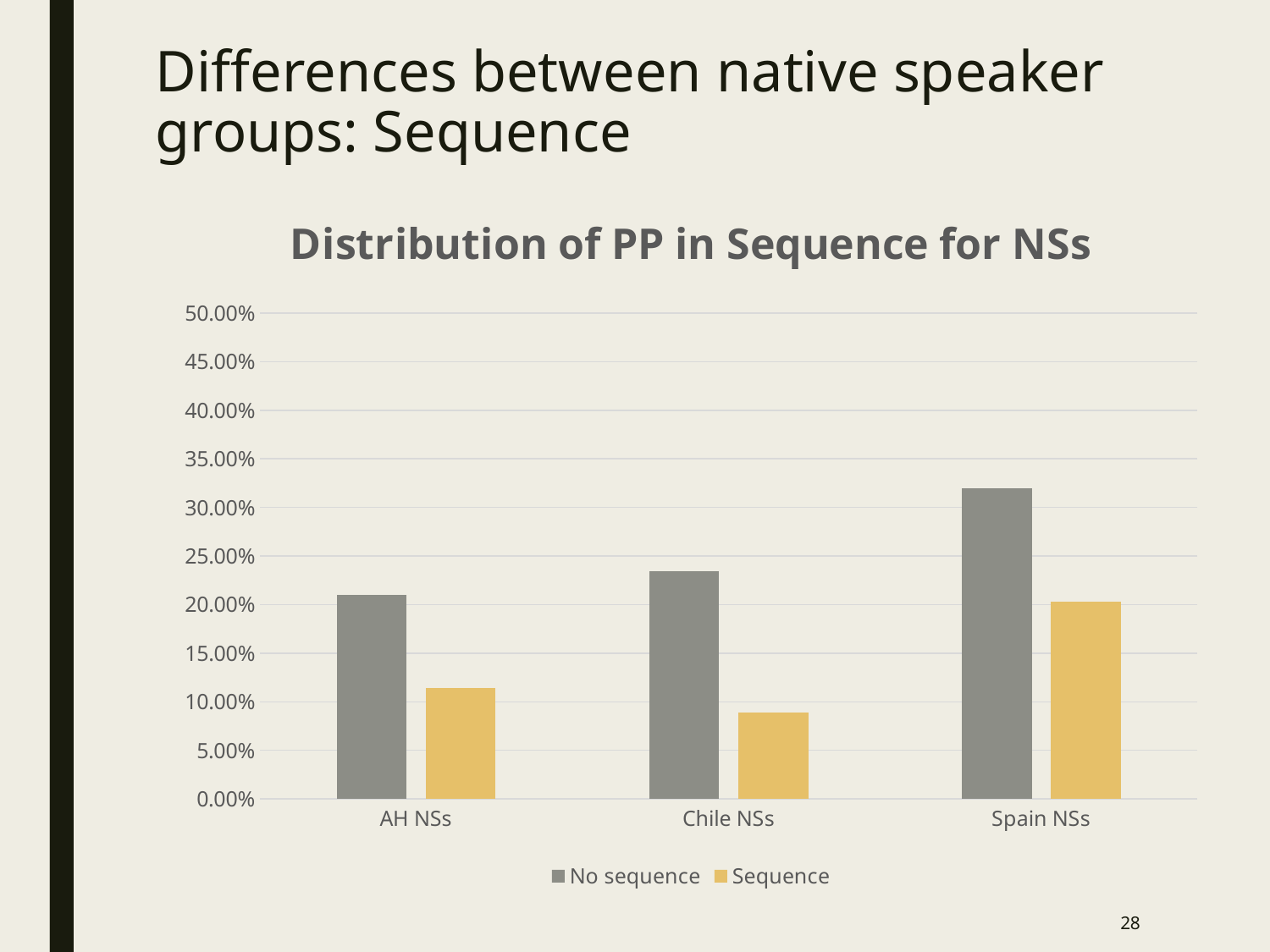
Is the Sequence value for Chile NSs greater or less than 10.00%? less Which native speaker group has the highest No sequence value? Spain NSs Which series is shown in yellow in the legend? Sequence How many native speaker groups are shown on the x axis? 3 Which native speaker group has the lowest Sequence value? Chile NSs Is the Sequence value for Spain NSs greater or less than 15.00%? greater What type of chart is shown on the slide? bar chart How many series does the legend list? 2 Is the No sequence value for Spain NSs greater or less than 30.00%? greater Which native speaker group has the lowest No sequence value? AH NSs What is the title of the chart? Distribution of PP in Sequence for NSs For Chile NSs, which is larger: the No sequence value or the Sequence value? No sequence